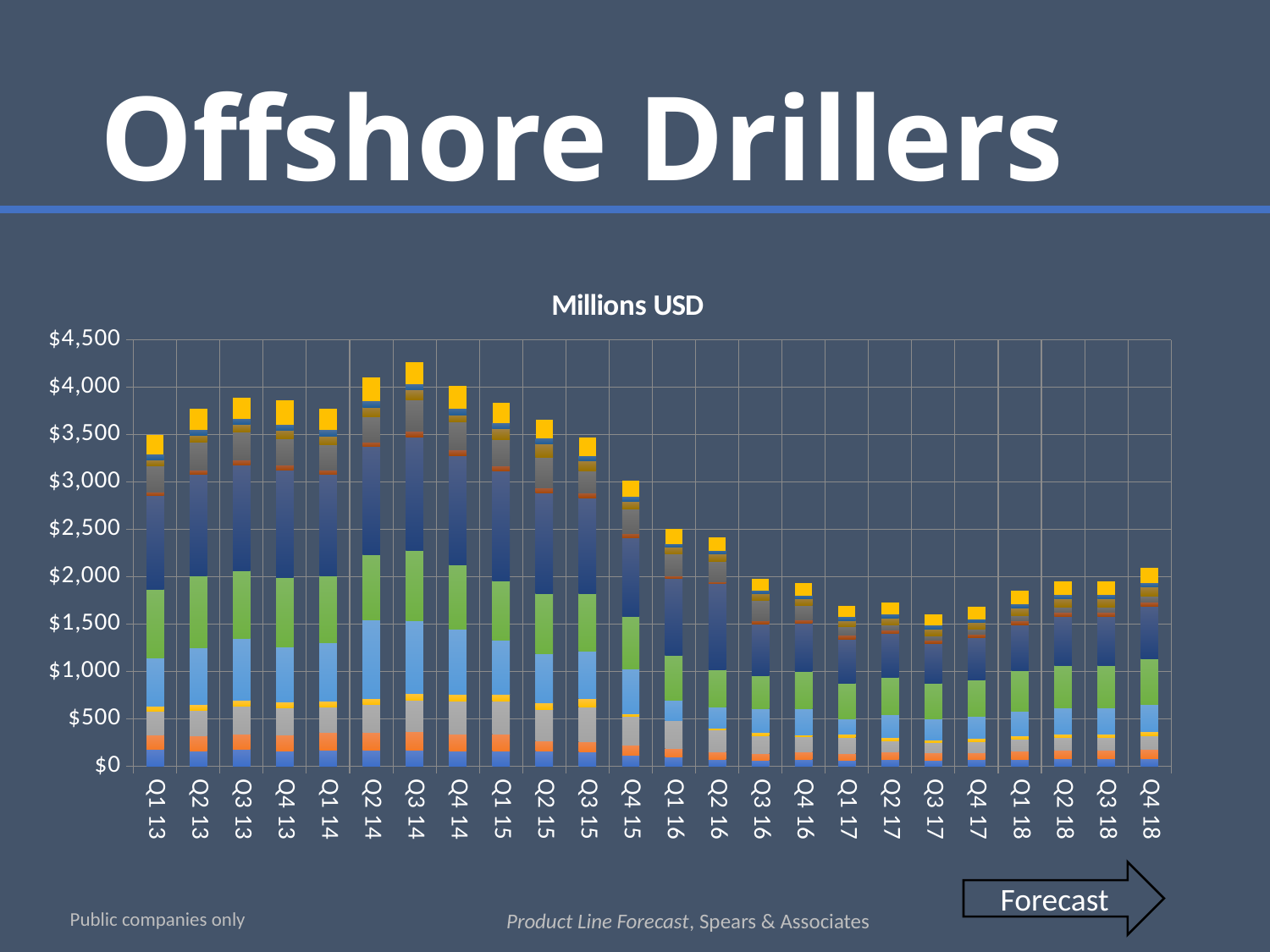
What is the title of the chart? Millions USD Is the total for Q1 17 greater or less than $2,000? less Is the total for Q3 14 greater or less than $4,000? greater Is the total for Q2 16 greater or less than $2,500? less What kind of chart is shown on the slide? Stacked bar chart Do the total bar heights generally rise or fall from Q3 14 to Q3 17? fall How many quarters are plotted along the x axis? 24 Which quarter has the highest total bar? Q3 14 Which has the larger total bar, Q2 13 or Q2 16? Q2 13 Which has the larger total bar, Q3 14 or Q1 17? Q3 14